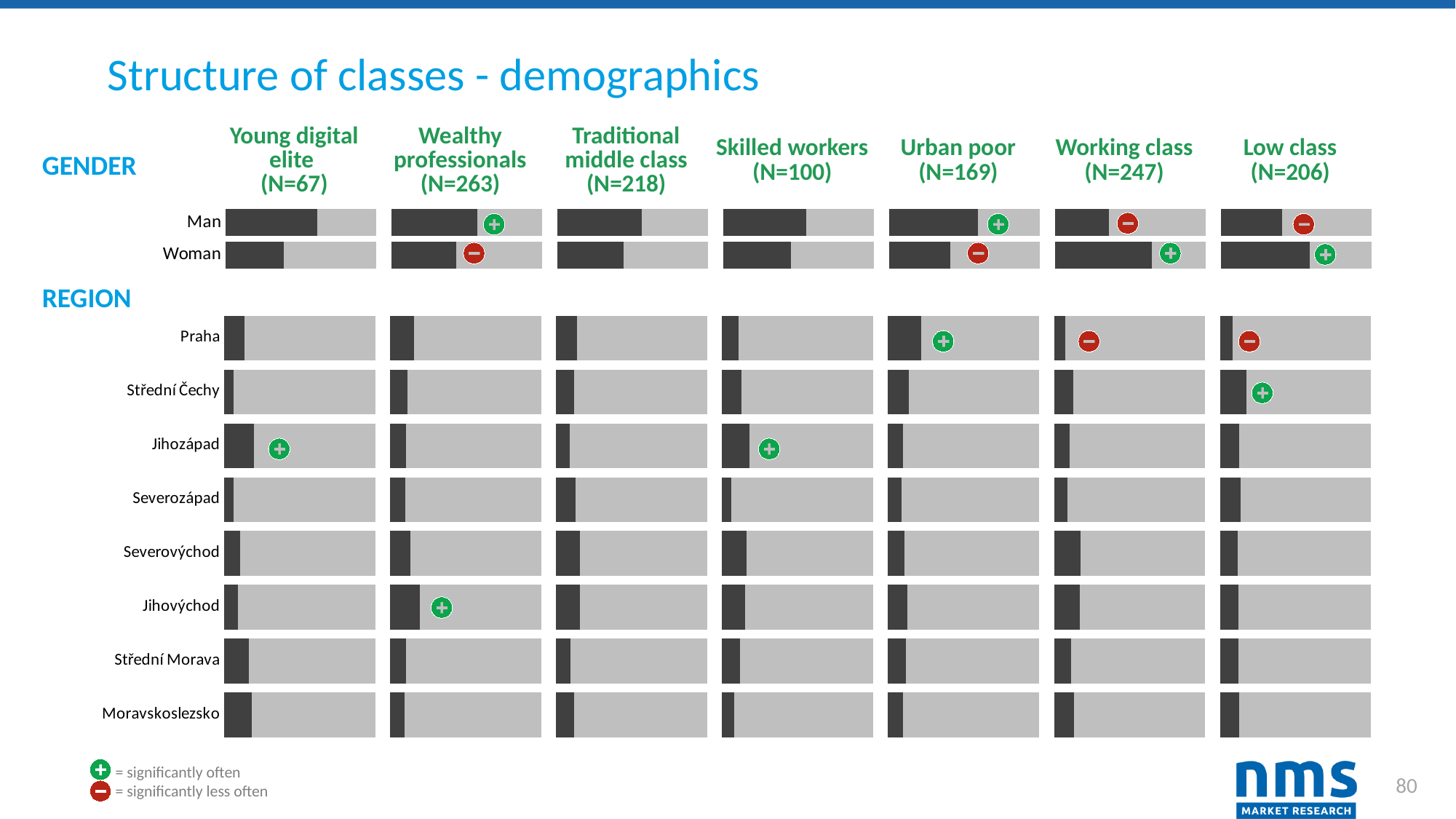
How many classes (columns) are shown on the slide? 7 How many regions are listed in the REGION section? 8 What is the sample size (N) shown for Wealthy professionals? N=263 In the Urban poor column, which region has the longest bar? Praha What kind of chart is used to show the gender and region structure of the classes? bar chart In the Young digital elite column, which gender bar is longer, Man or Woman? Man Which class has the largest sample size (N)? Wealthy professionals (N=263) Which class has the smallest sample size (N)? Young digital elite (N=67) In the Working class column, which gender bar is longer, Man or Woman? Woman Is the Praha bar longer in the Urban poor column or in the Low class column? Urban poor According to the legend, what does the green plus symbol mean? significantly often What is the sample size (N) shown for Low class? N=206